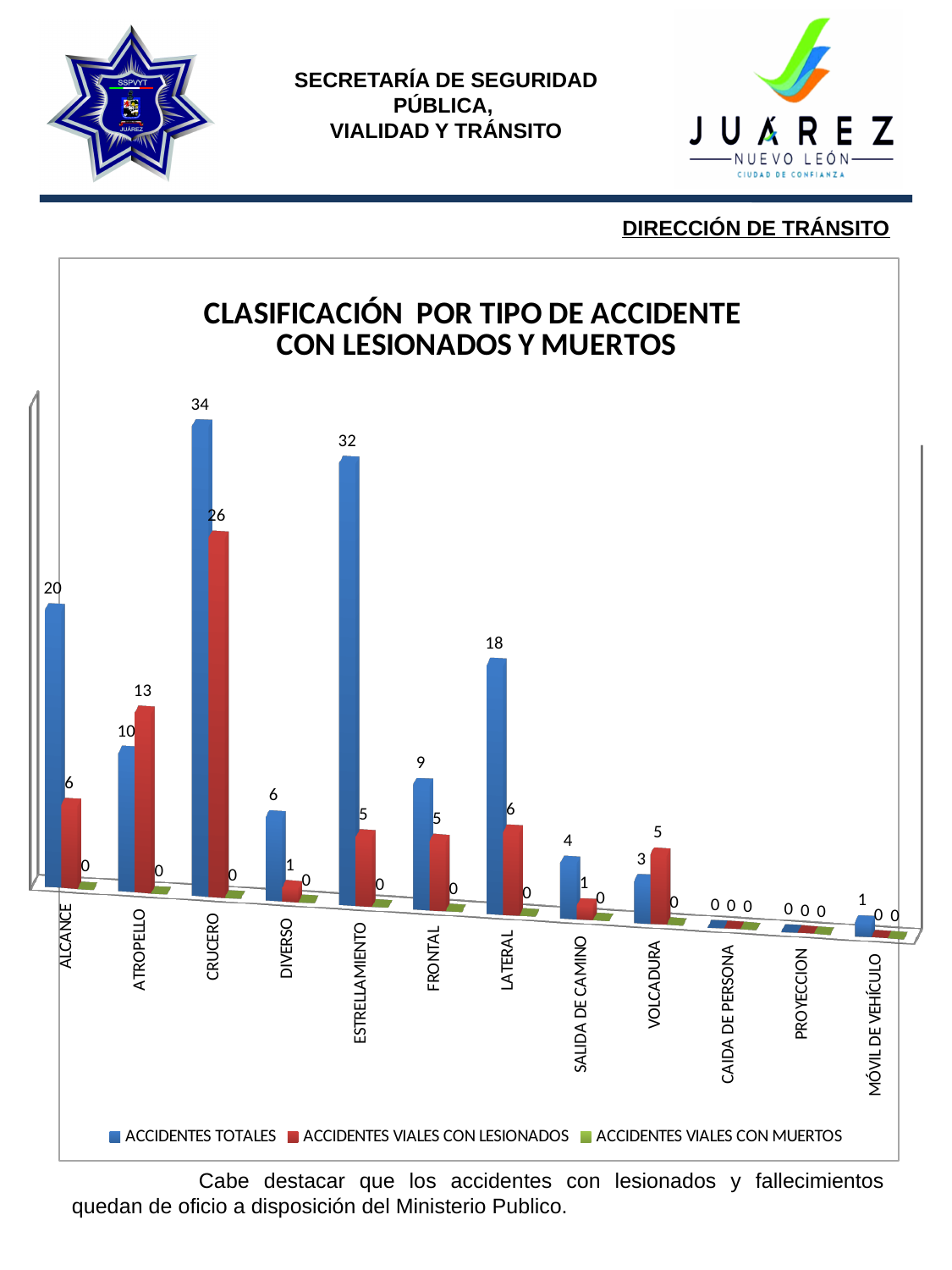
Which is larger for ATROPELLO: ACCIDENTES TOTALES or ACCIDENTES VIALES CON LESIONADOS? ACCIDENTES VIALES CON LESIONADOS How many accident type categories are shown on the x axis? 12 What is the value of ACCIDENTES TOTALES for CRUCERO? 34 Which category has the highest value of ACCIDENTES VIALES CON LESIONADOS? CRUCERO How many series does the legend list? 3 What is the value of ACCIDENTES VIALES CON LESIONADOS for ATROPELLO? 13 What kind of chart is shown on the slide? Bar chart What is the difference in ACCIDENTES TOTALES between ALCANCE and LATERAL? 2 What is the value of ACCIDENTES TOTALES for ESTRELLAMIENTO? 32 What is the difference between ACCIDENTES TOTALES and ACCIDENTES VIALES CON LESIONADOS for CRUCERO? 8 Which category has the highest value of ACCIDENTES TOTALES? CRUCERO What is the value of ACCIDENTES VIALES CON LESIONADOS for VOLCADURA? 5